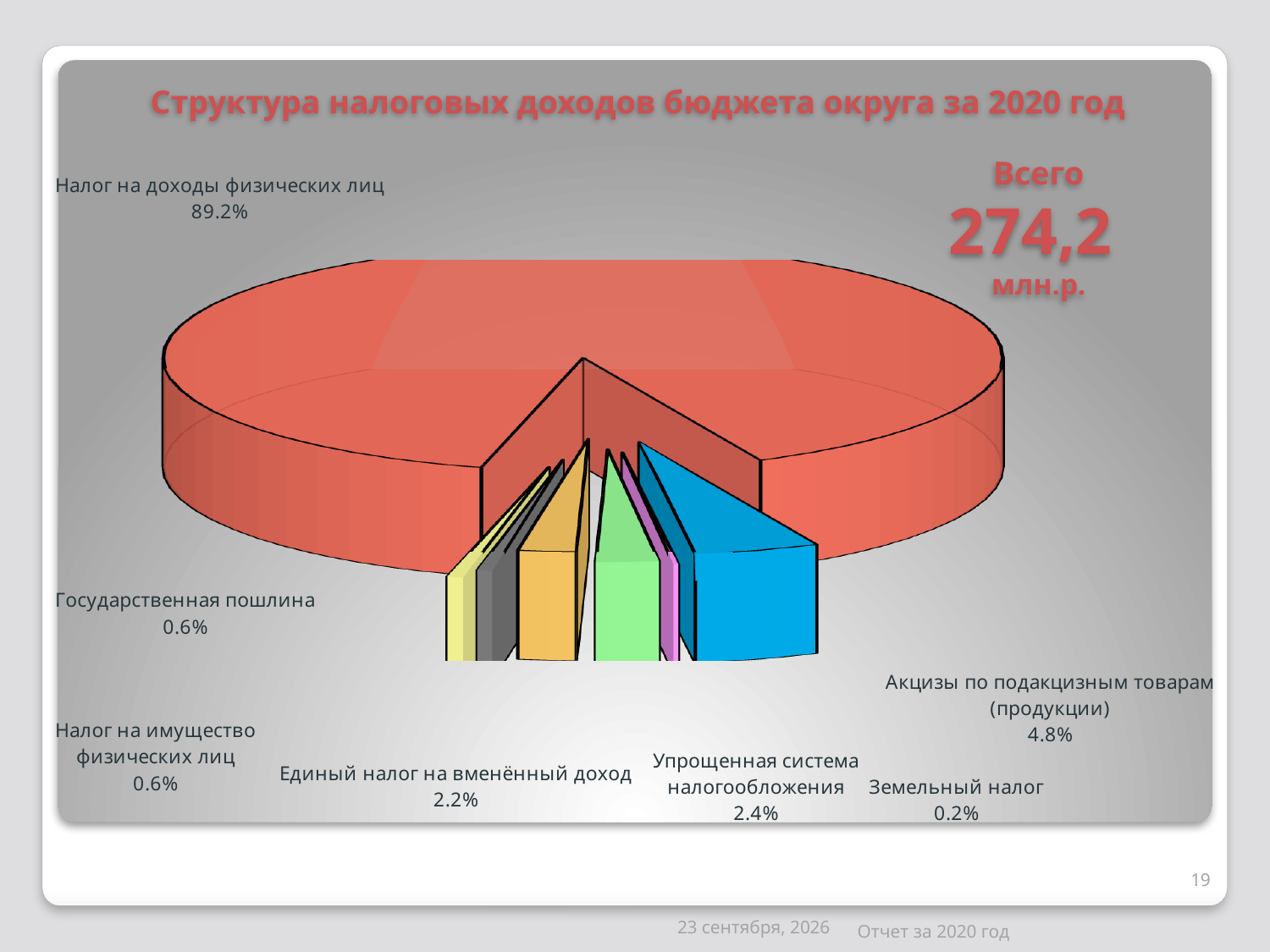
What kind of chart is shown on the slide? Pie chart Which category has the largest share of the pie? Налог на доходы физических лиц What is the value shown for "Акцизы по подакцизным товарам (продукции)"? 4.8% What total amount is stated next to the chart? 274,2 млн.р. What is the value shown for "Упрощенная система налогообложения"? 2.4% What is the value shown for "Земельный налог"? 0.2% Which is larger: the share of "Единый налог на вменённый доход" or the share of "Упрощенная система налогообложения"? Упрощенная система налогообложения What is the difference between the shares of "Акцизы по подакцизным товарам (продукции)" and "Упрощенная система налогообложения"? 2.4% What is the value shown for "Единый налог на вменённый доход"? 2.2% What share of the pie does "Налог на доходы физических лиц" have? 89.2% How many categories are shown in the pie chart? 7 Which category has the smallest share of the pie? Земельный налог